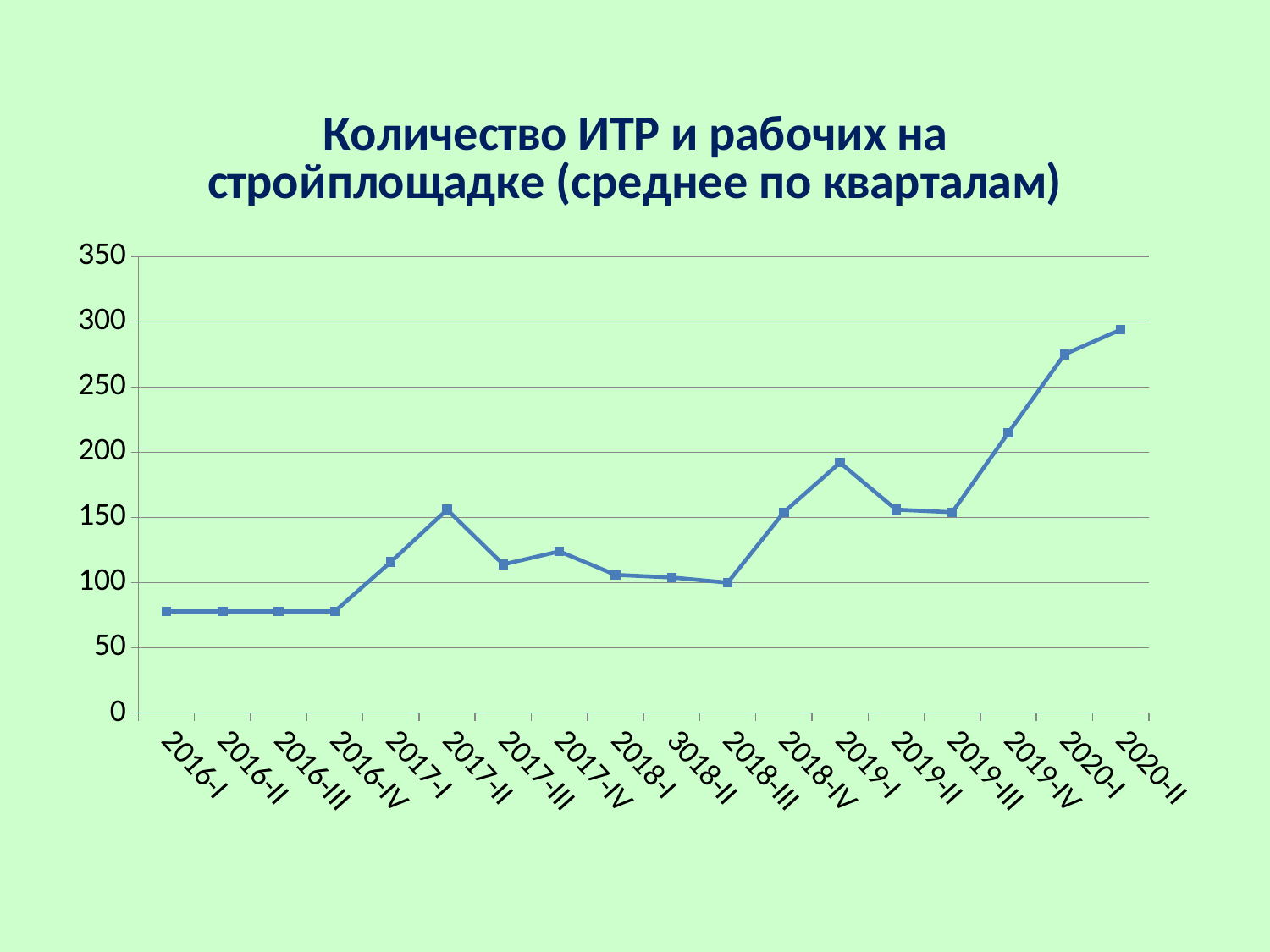
Which quarter has the highest value? 2020-II How many quarters (data points) are plotted on the x axis? 18 What is the title of the chart? Количество ИТР и рабочих на стройплощадке (среднее по кварталам) Is the value for 2020-I greater or less than 250? greater Which is larger, the value for 2018-IV or the value for 2019-I? 2019-I Is the value for 2016-I greater or less than 100? less Is the value for 2019-I greater or less than 200? less Which is larger, the value for 2019-I or the value for 2017-II? 2019-I Overall, do the values rise or fall from 2016-I to 2020-II? rise What kind of chart is shown on the slide? line chart